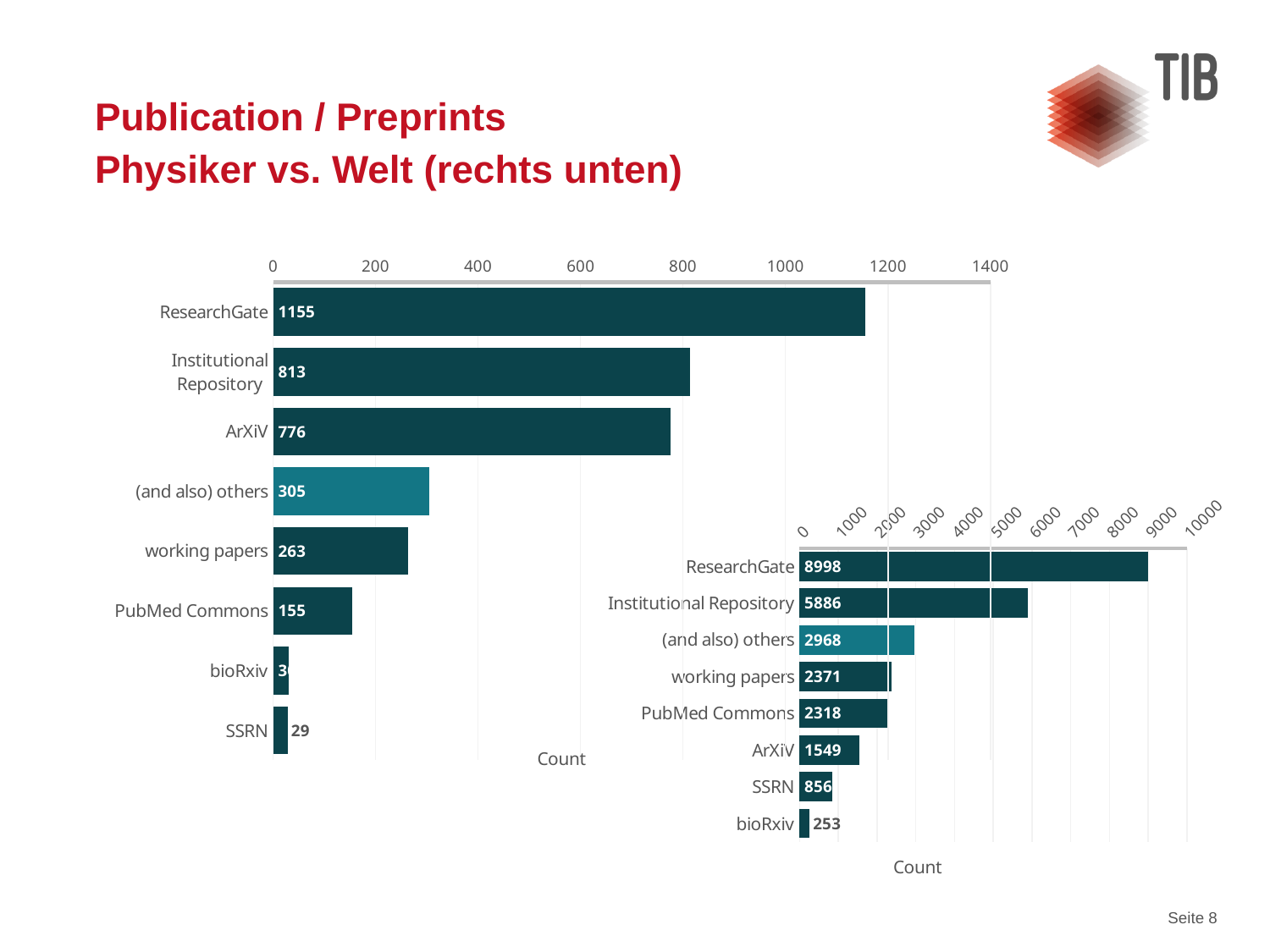
In the left chart, what is the difference between the counts for Institutional Repository and ArXiV? 37 In the bottom-right chart, what is the count for bioRxiv? 253 In the left chart, what is the count for ResearchGate? 1155 In the left chart, which category has the highest count? ResearchGate What kind of chart is the left chart? bar chart In the bottom-right chart, which has a larger count, working papers or PubMed Commons? working papers In the bottom-right chart, what is the count for Institutional Repository? 5886 In the bottom-right chart, which category has the lowest count? bioRxiv How many categories are shown in the bottom-right chart? 8 In the left chart, what is the count for ArXiV? 776 In the bottom-right chart, what is the difference between the counts for ResearchGate and Institutional Repository? 3112 In the left chart, is the value for (and also) others greater or less than 400? less